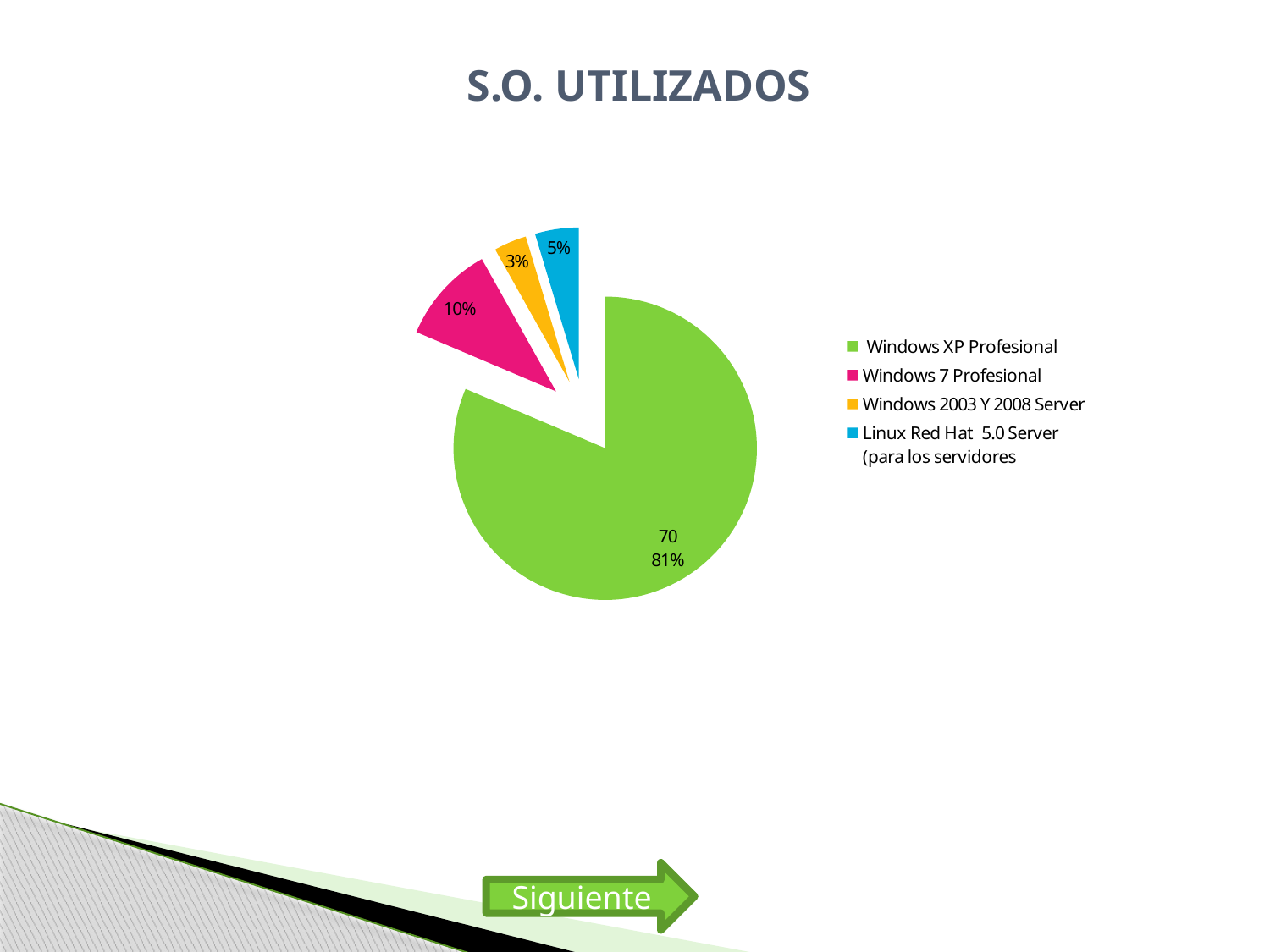
What kind of chart is shown on the slide? pie chart What percentage share does Linux Red Hat 5.0 Server have? 5% What percentage share does Windows XP Profesional have? 81% What percentage share does Windows 7 Profesional have? 10% Which has a larger share, Windows 7 Profesional or Linux Red Hat 5.0 Server? Windows 7 Profesional What is the title of the slide containing the pie chart? S.O. UTILIZADOS What value is printed on the Windows XP Profesional slice? 70 How many slices does the pie chart have? 4 Which operating system has the smallest share of the pie? Windows 2003 Y 2008 Server What is the difference in percentage points between the Windows 7 Profesional share and the Linux Red Hat 5.0 Server share? 5 percentage points Which operating system has the largest share of the pie? Windows XP Profesional